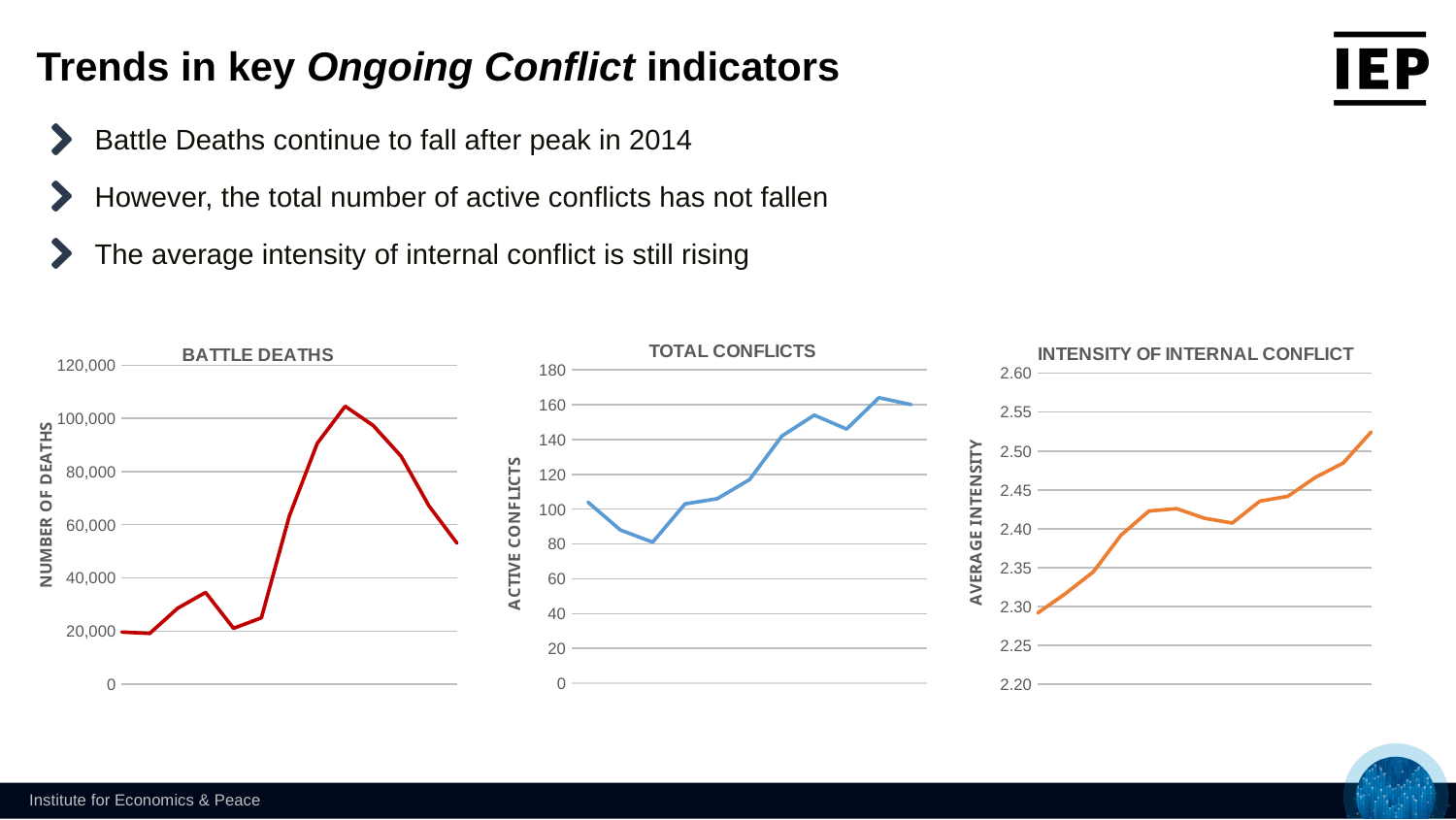
In the Intensity of Internal Conflict chart, is the last value on the right greater or less than 2.45? greater What is the y-axis label of the Battle Deaths chart? NUMBER OF DEATHS In the Intensity of Internal Conflict chart, is the first value on the left greater or less than 2.35? less What kind of chart is the Intensity of Internal Conflict chart? line chart In the Battle Deaths chart, is the peak value greater or less than 100,000? greater What kind of chart is the Battle Deaths chart? line chart In the Total Conflicts chart, do the values overall rise or fall from left to right? rise In the Intensity of Internal Conflict chart, do the values generally rise or fall along the x axis? rise